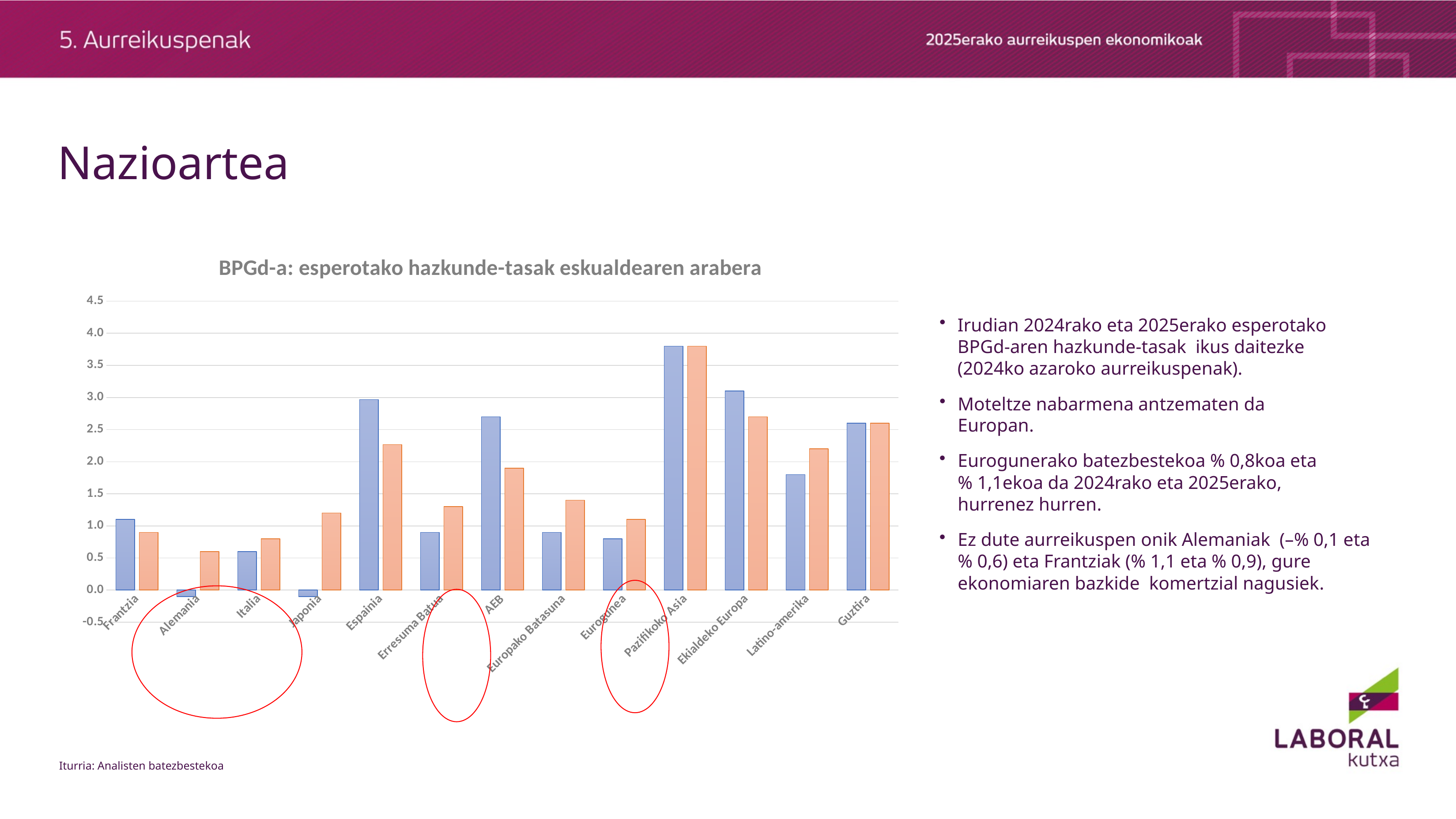
What kind of chart is shown on the slide? bar chart Is the blue bar for Espainia greater or less than 2.5? greater What is the title of the chart? BPGd-a: esperotako hazkunde-tasak eskualdearen arabera Is the blue bar for Guztira greater or less than 2.0? greater Is the orange bar for Ekialdeko Europa greater or less than 2.5? greater How many categories are shown on the x axis of the chart? 13 Which is larger, the orange bar for Pazifikoko Asia or the orange bar for Latino-amerika? Pazifikoko Asia Which is larger, the blue bar for Espainia or the blue bar for Frantzia? Espainia Which category has the highest orange bar in the chart? Pazifikoko Asia Which category has the highest blue bar in the chart? Pazifikoko Asia